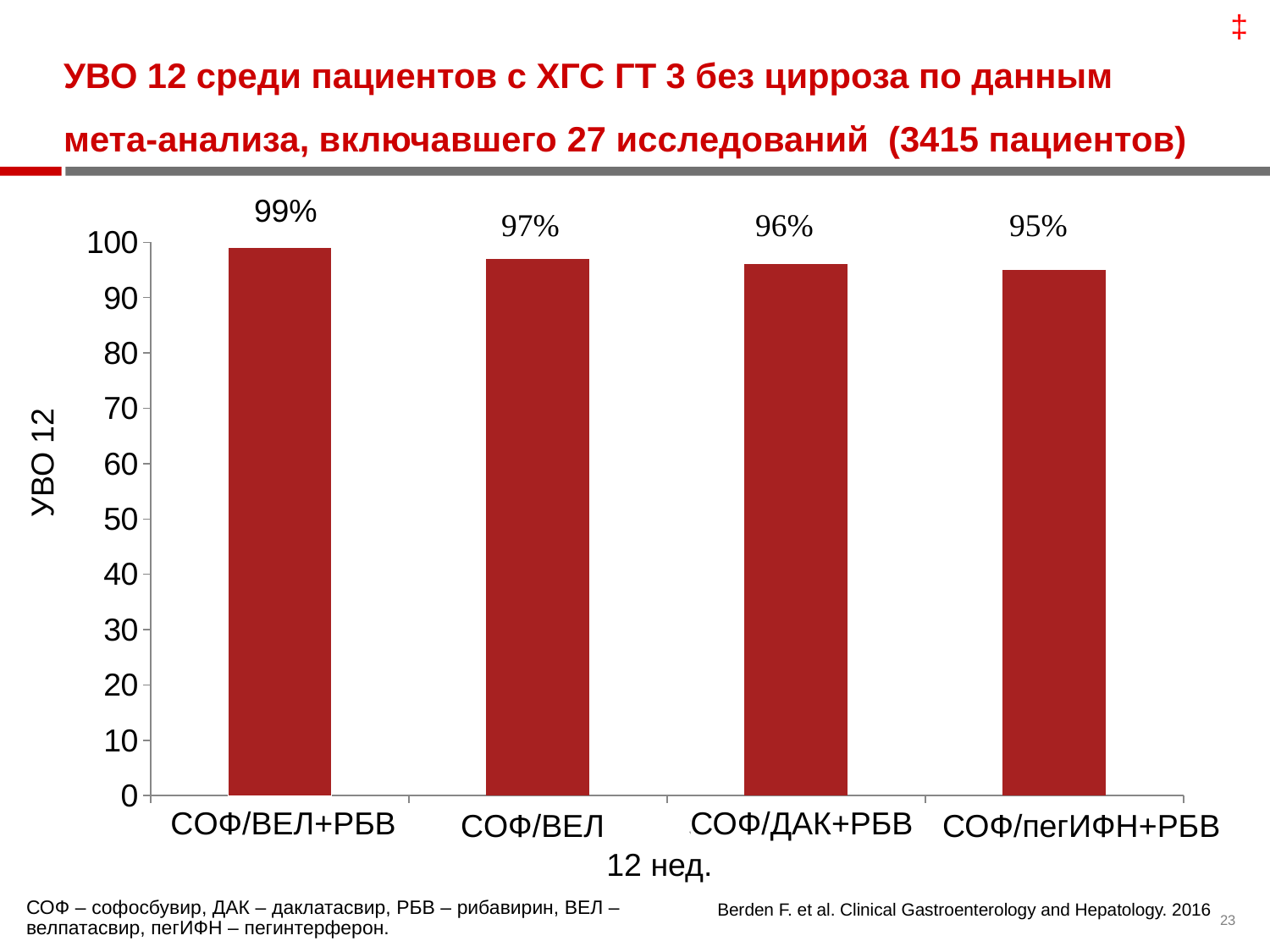
What is the УВО 12 value for СОФ/ВЕЛ+РБВ? 99% What is the УВО 12 value for СОФ/ДАК+РБВ? 96% Which has a higher УВО 12 value, СОФ/ВЕЛ or СОФ/ДАК+РБВ? СОФ/ВЕЛ What is the difference between the УВО 12 values for СОФ/ВЕЛ+РБВ and СОФ/пегИФН+РБВ? 4% Do the УВО 12 values rise or fall from left to right across the chart? Fall What is the label of the vertical axis? УВО 12 What is the УВО 12 value for СОФ/пегИФН+РБВ? 95% Which regimen has the highest УВО 12 value? СОФ/ВЕЛ+РБВ What kind of chart is shown on the slide? Bar chart Which regimen has the lowest УВО 12 value? СОФ/пегИФН+РБВ How many regimens are shown on the chart? 4 What is the УВО 12 value for СОФ/ВЕЛ? 97%